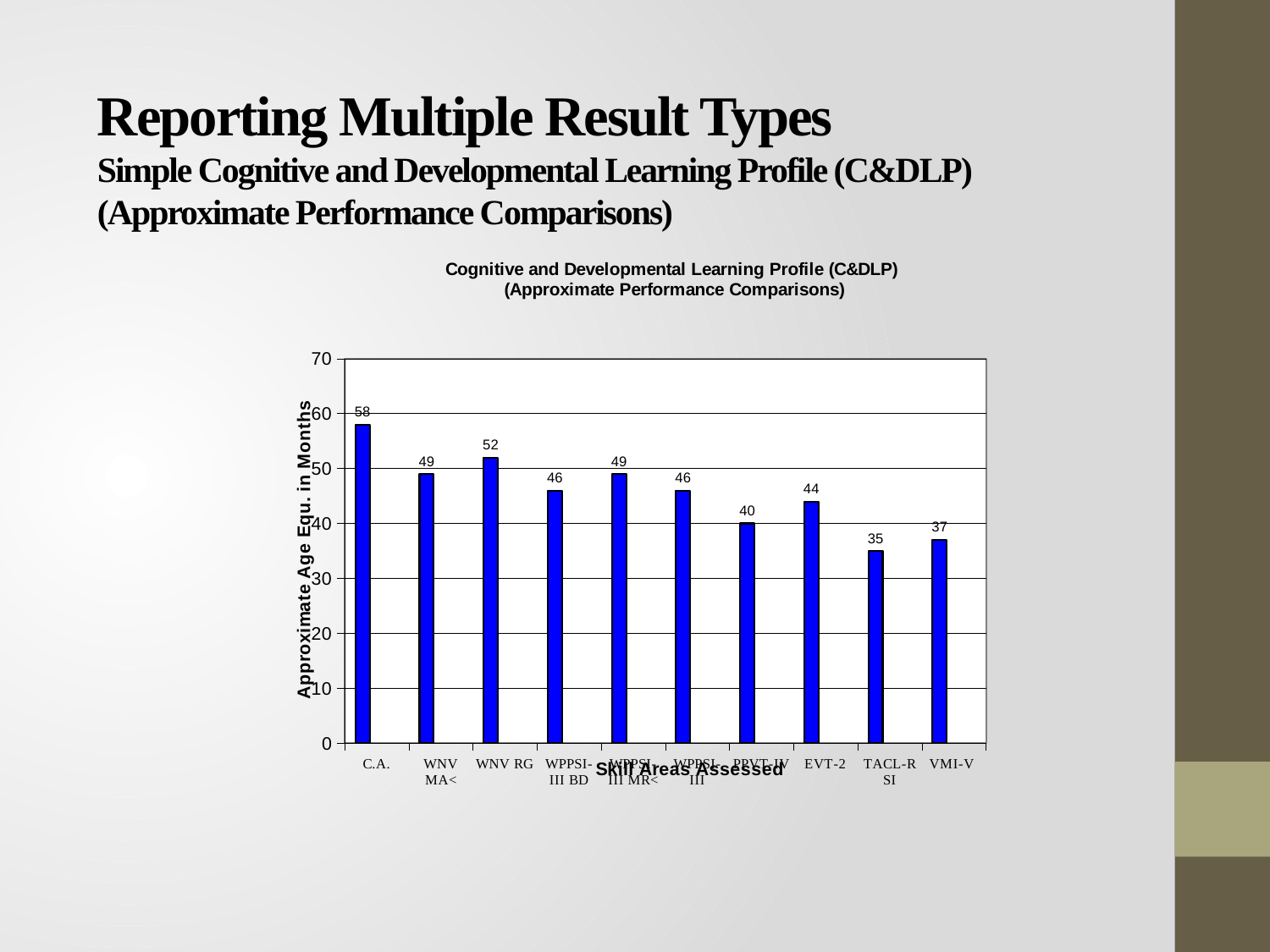
What is the value for C.A.? 58 Which skill area has the highest value? C.A. Which skill area has the lowest value? TACL-R SI What is the difference between the values for C.A. and TACL-R SI? 23 What is the value for WNV RG? 52 How many bars are shown in the chart? 10 What kind of chart is shown on the slide? Bar chart Which is larger, the value for WNV RG or the value for WNV MA<? WNV RG What is the value for TACL-R SI? 35 What is the value for EVT-2? 44 What is the value for WPPSI-III BD? 46 What is the difference between the values for VMI-V and TACL-R SI? 2